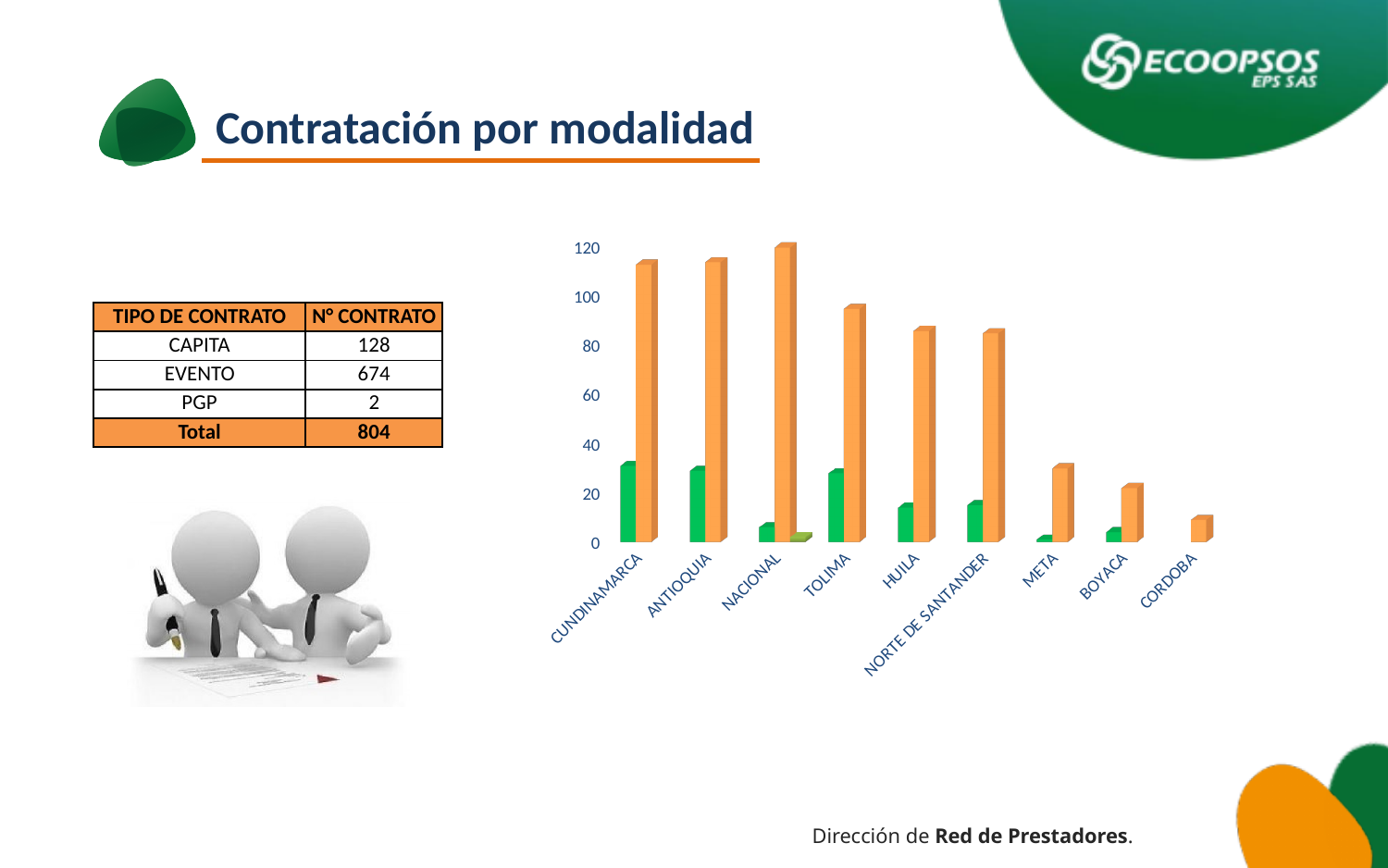
Is the orange bar for CORDOBA greater or less than 20? less Is the green bar for NACIONAL greater or less than 20? less Which category has the tallest orange bar? NACIONAL What kind of chart is shown on the slide? bar chart Do the orange bars rise or fall from TOLIMA to CORDOBA along the x axis? fall Which has the taller orange bar, TOLIMA or HUILA? TOLIMA Which category has the tallest green bar? CUNDINAMARCA Which has the taller green bar, ANTIOQUIA or META? ANTIOQUIA Is the orange bar for META greater or less than 40? less Which category has the shortest orange bar? CORDOBA How many categories are shown on the x axis of the chart? 9